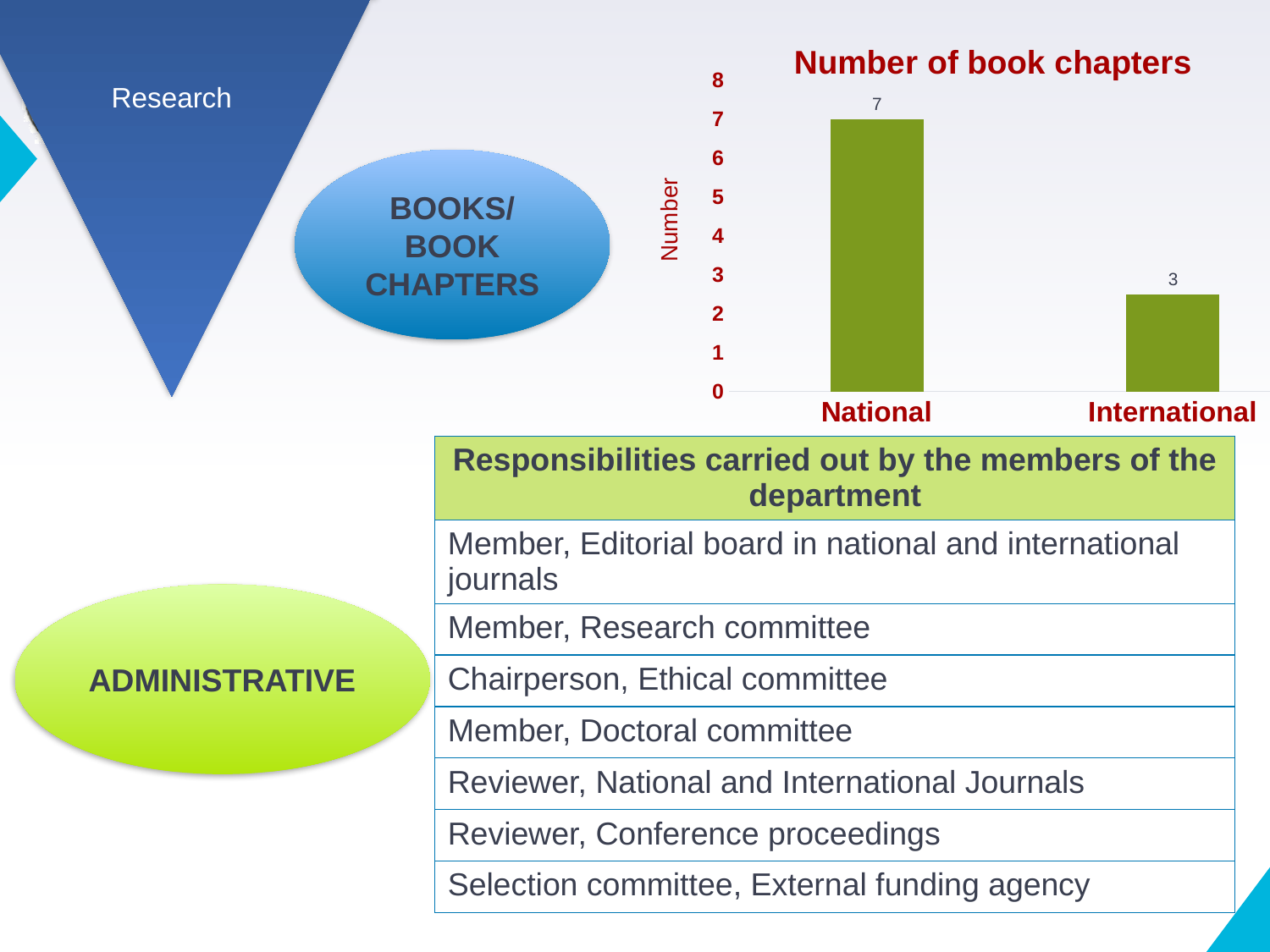
What is the label of the vertical axis of the chart? Number Which category has the lowest number of book chapters? International What is the title of the chart? Number of book chapters What is the number of book chapters for International? 3 Is the value for International greater or less than 4? less Is the value for National greater or less than 6? greater What kind of chart is shown on the slide? bar chart How many categories are shown in the chart? 2 What is the difference between the number of National and International book chapters? 4 Which category has the highest number of book chapters? National Which is larger, the number of National book chapters or International book chapters? National What is the number of book chapters for National? 7